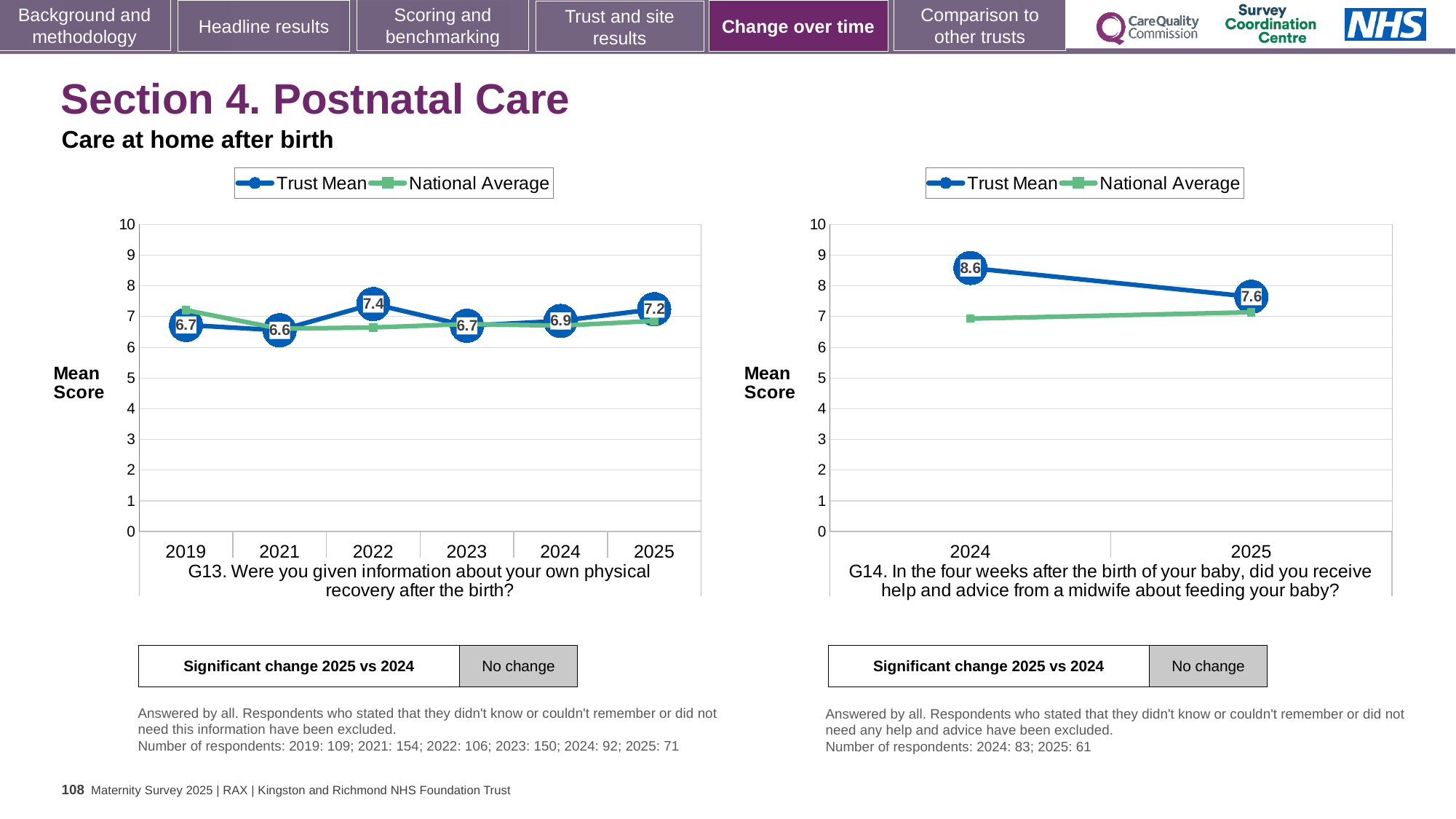
In the G13 chart, which year has the lowest Trust Mean score? 2021 In the G13 chart, what is the Trust Mean score for 2022? 7.4 In the G14 chart, what is the Trust Mean score for 2024? 8.6 How many years are shown on the x axis of the G13 chart? 6 In the G14 chart, is the Trust Mean score for 2024 or 2025 higher? 2024 In the G13 chart, what is the difference between the Trust Mean scores for 2022 and 2021? 0.8 What type of chart is the G13 chart? line chart In the G13 chart, which year has the highest Trust Mean score? 2022 How many series does the legend of the G14 chart list? 2 In the G13 chart, what is the Trust Mean score for 2025? 7.2 In the G14 chart, what is the difference between the Trust Mean scores for 2024 and 2025? 1.0 In the G14 chart, is the National Average for 2024 greater or less than 8? less